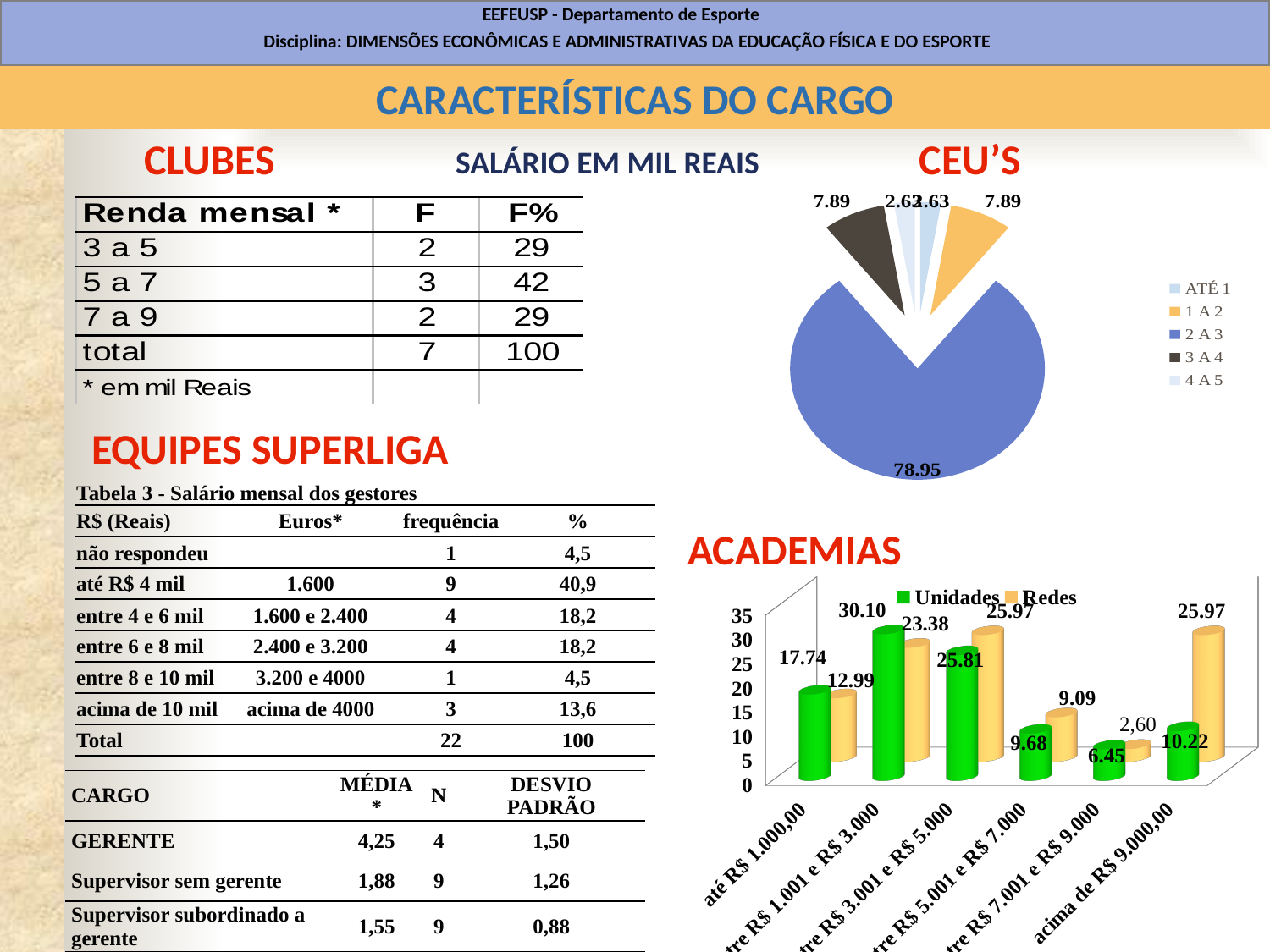
In the ACADEMIAS chart, what is the Unidades value for 'até R$ 1.000,00'? 17.74 How many categories does the legend of the CEU'S pie chart list? 5 In the ACADEMIAS chart, which category has the highest Unidades value? entre R$ 1.001 e R$ 3.000 How many series does the legend of the ACADEMIAS chart list? 2 What kind of chart is the ACADEMIAS chart? bar chart In the CEU'S pie chart, what is the value of the 2 A 3 slice? 78.95 In the ACADEMIAS chart, what is the difference between the Unidades and Redes values for 'até R$ 1.000,00'? 4.75 In the CEU'S pie chart, which category has the largest slice? 2 A 3 In the CEU'S pie chart, what is the value of the 1 A 2 slice? 7.89 What kind of chart is the CEU'S chart? pie chart In the ACADEMIAS chart, which is larger for 'acima de R$ 9.000,00': Unidades or Redes? Redes In the ACADEMIAS chart, which category has the lowest Redes value? entre R$ 7.001 e R$ 9.000